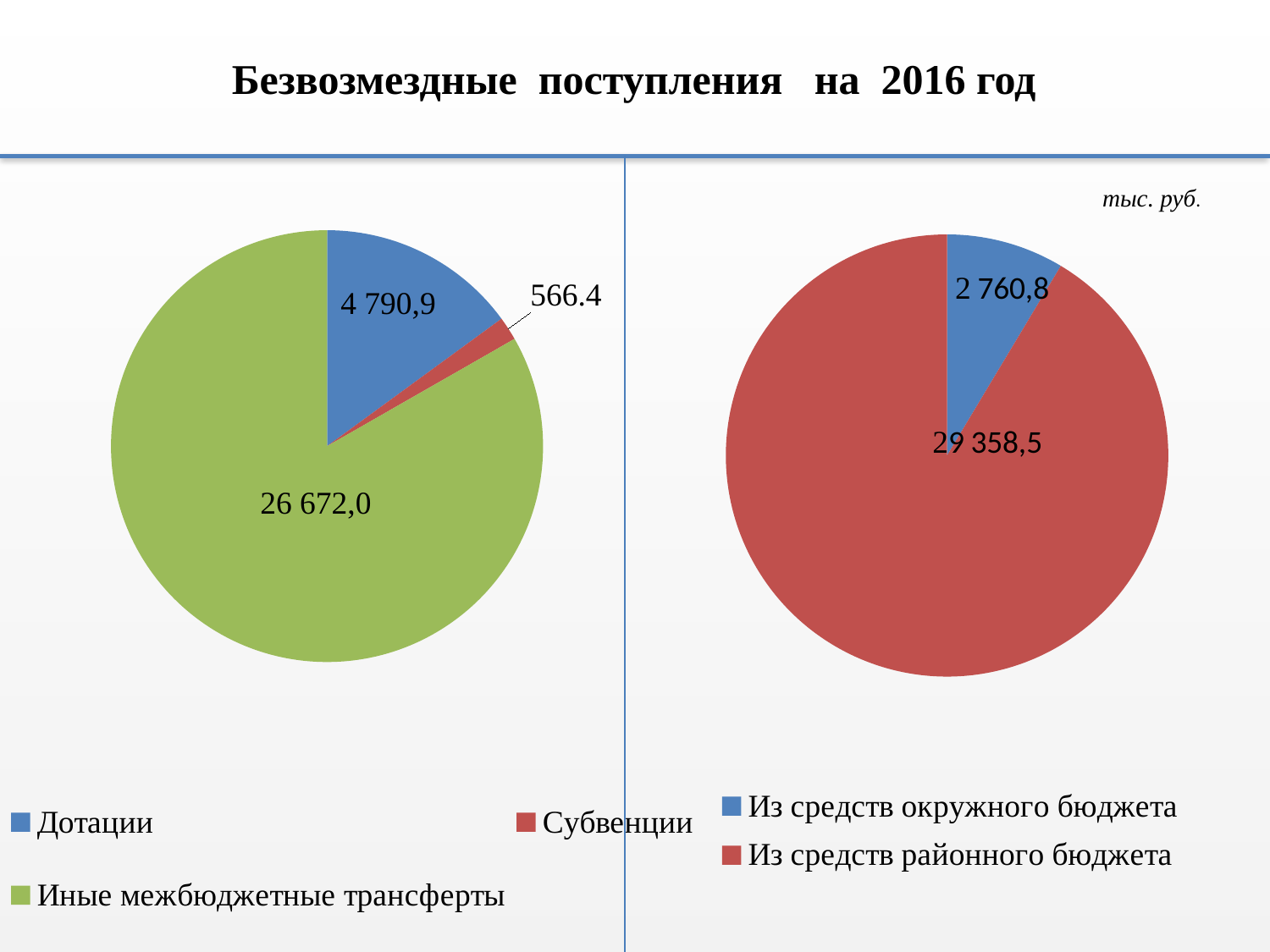
In the right pie chart, what is the value for Из средств окружного бюджета? 2 760,8 In the right pie chart, what is the difference between Из средств районного бюджета and Из средств окружного бюджета? 26 597,7 In the left pie chart, which category has the smallest value? Субвенции In the left pie chart, what is the difference between Иные межбюджетные трансферты and Дотации? 21 881,1 In the left pie chart, what is the value for Иные межбюджетные трансферты? 26 672,0 What type of chart is used on the right side of the slide? Pie chart In the left pie chart, what is the value for Субвенции? 566.4 In the left pie chart, which category has the largest value? Иные межбюджетные трансферты In the right pie chart, which category is larger: Из средств окружного бюджета or Из средств районного бюджета? Из средств районного бюджета In the right pie chart, what is the value for Из средств районного бюджета? 29 358,5 How many categories does the left pie chart show? 3 In the left pie chart, what is the value for Дотации? 4 790,9